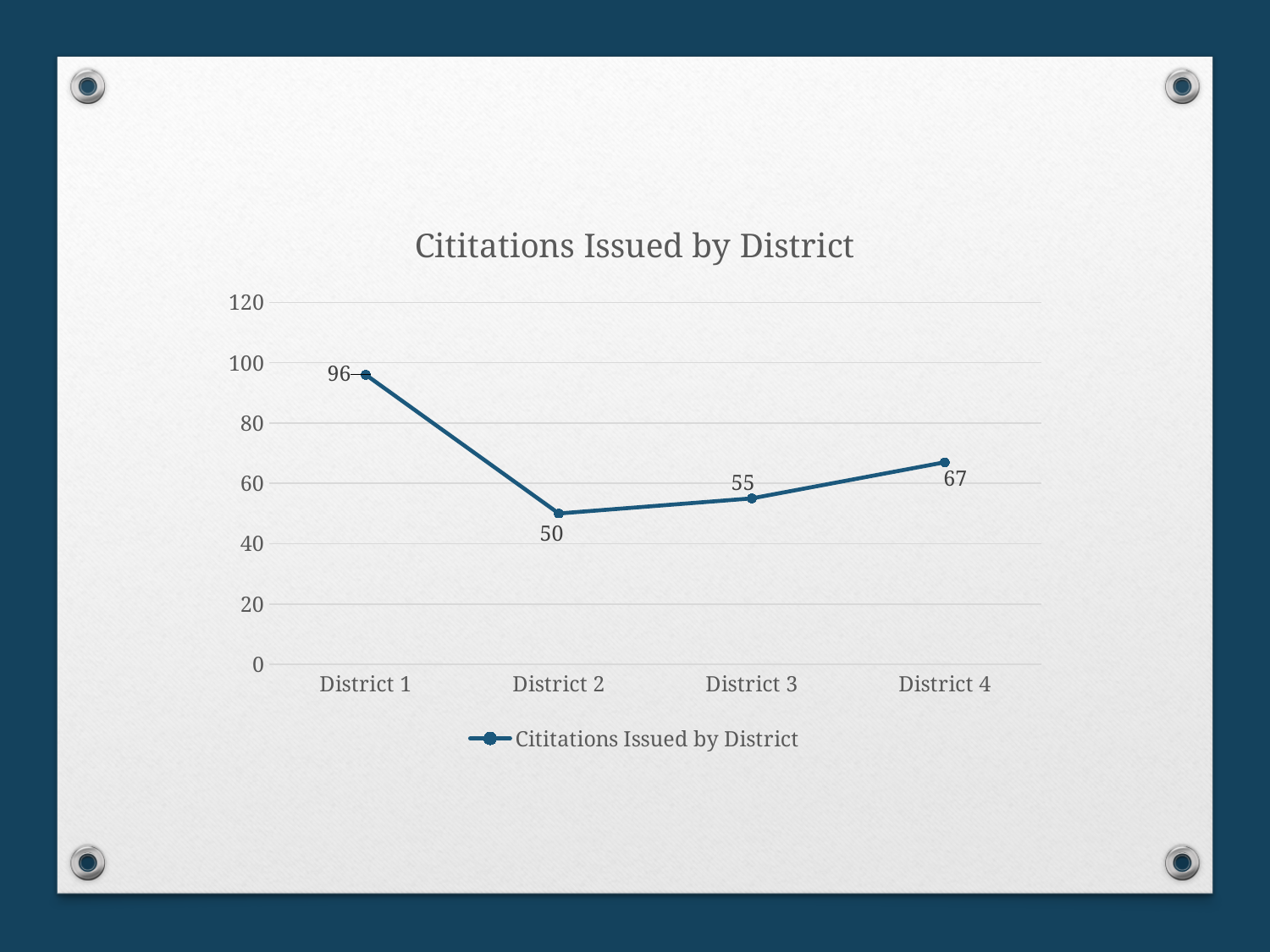
What kind of chart is shown on the slide? Line chart What is the difference between the values for District 4 and District 3? 12 How many districts are plotted on the chart? 4 What is the value for District 4? 67 Which is larger, the value for District 3 or District 4? District 4 What is the title of the chart? Cititations Issued by District Which district has the highest number of citations issued? District 1 Which district has the lowest number of citations issued? District 2 What is the value for District 2? 50 What is the value for District 1? 96 What is the value for District 3? 55 What is the difference between the values for District 1 and District 2? 46